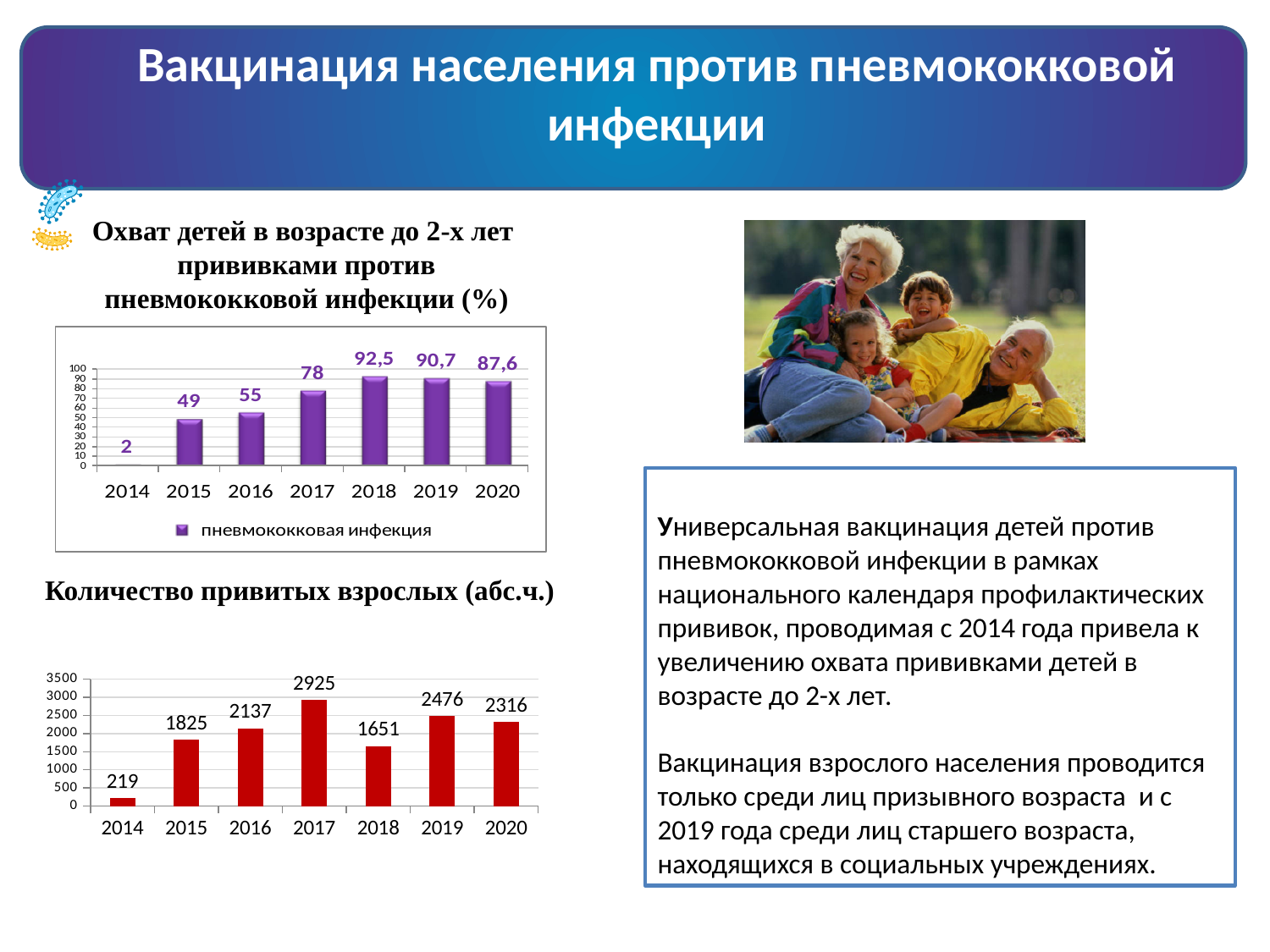
How many years are shown on the x axis of the bottom chart on the number of vaccinated adults? 7 What type of chart is the bottom chart on the number of vaccinated adults? bar chart In the top chart on children's vaccination coverage, which year has the highest value? 2018 In the top chart on children's vaccination coverage, how many series does the legend list? 1 In the top chart on children's vaccination coverage, what is the legend entry? пневмококковая инфекция In the bottom chart on the number of vaccinated adults, what is the difference between the values for 2019 and 2018? 825 In the bottom chart (Количество привитых взрослых (абс.ч.)), what is the value for 2017? 2925 In the top chart on children's vaccination coverage, which year has the lowest value? 2014 In the bottom chart on the number of vaccinated adults, which is larger: the value for 2019 or the value for 2020? 2019 In the top chart on children's vaccination coverage, what is the difference between the values for 2017 and 2016? 23 In the top chart (Охват детей в возрасте до 2-х лет прививками против пневмококковой инфекции), what is the value for 2018? 92,5 In the bottom chart on the number of vaccinated adults, which year has the lowest value? 2014